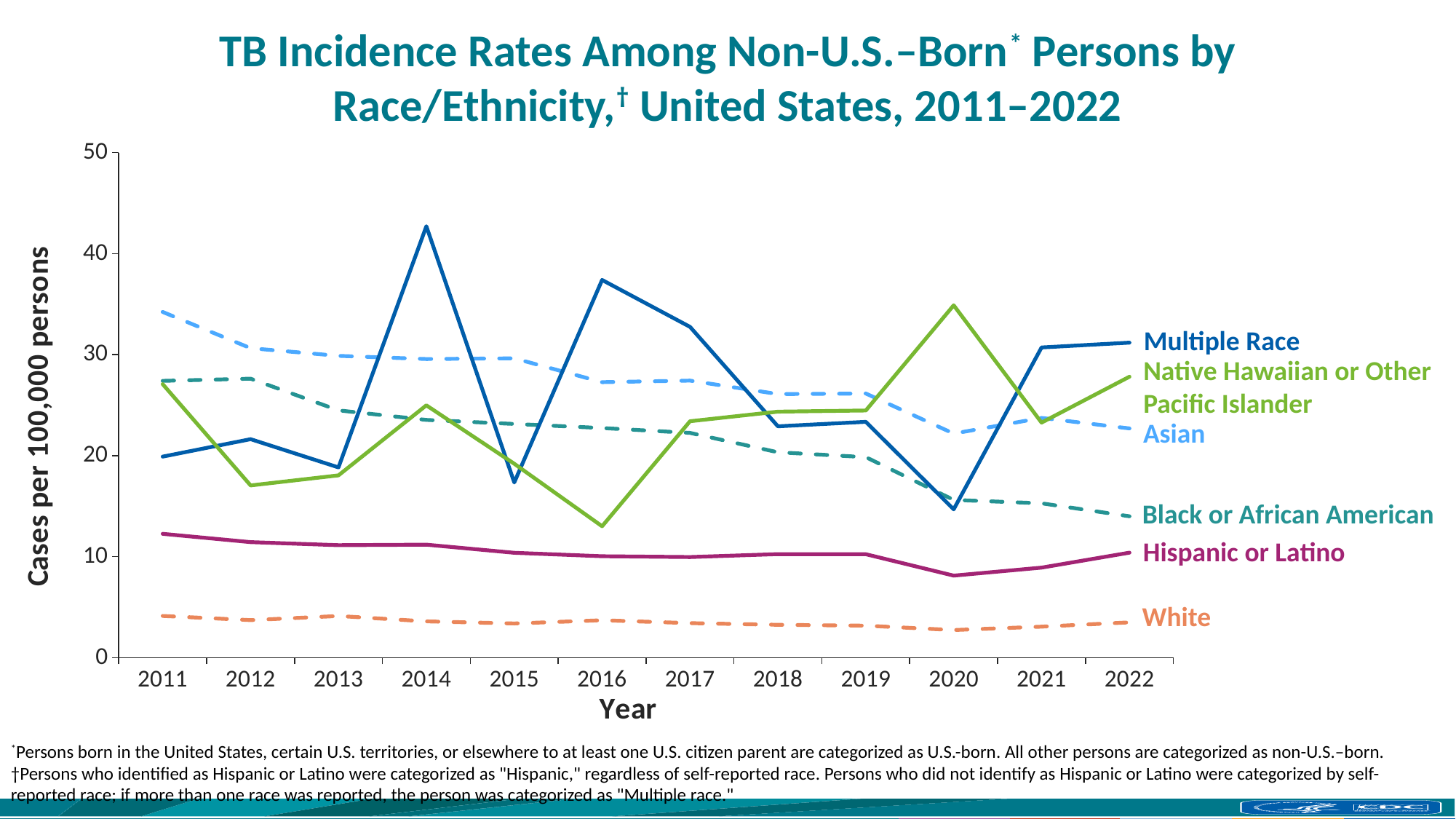
How many years are shown along the x axis? 12 What kind of chart is shown on the slide? Line chart In 2016, which is larger: the rate for Multiple Race or the rate for Native Hawaiian or Other Pacific Islander? Multiple Race Which race/ethnicity group has the highest TB incidence rate in 2011? Asian Which race/ethnicity group has the lowest TB incidence rate in 2022? White Which race/ethnicity group has the highest TB incidence rate in 2014? Multiple Race Is the value for Native Hawaiian or Other Pacific Islander in 2020 greater or less than 30? greater Does the TB incidence rate for Asian persons rise or fall from 2011 to 2022? Fall What is the label on the y axis of the chart? Cases per 100,000 persons Is the value for Hispanic or Latino in 2020 greater or less than 10? less How many race/ethnicity series are plotted on the chart? 6 Is the value for Multiple Race in 2014 greater or less than 40? greater